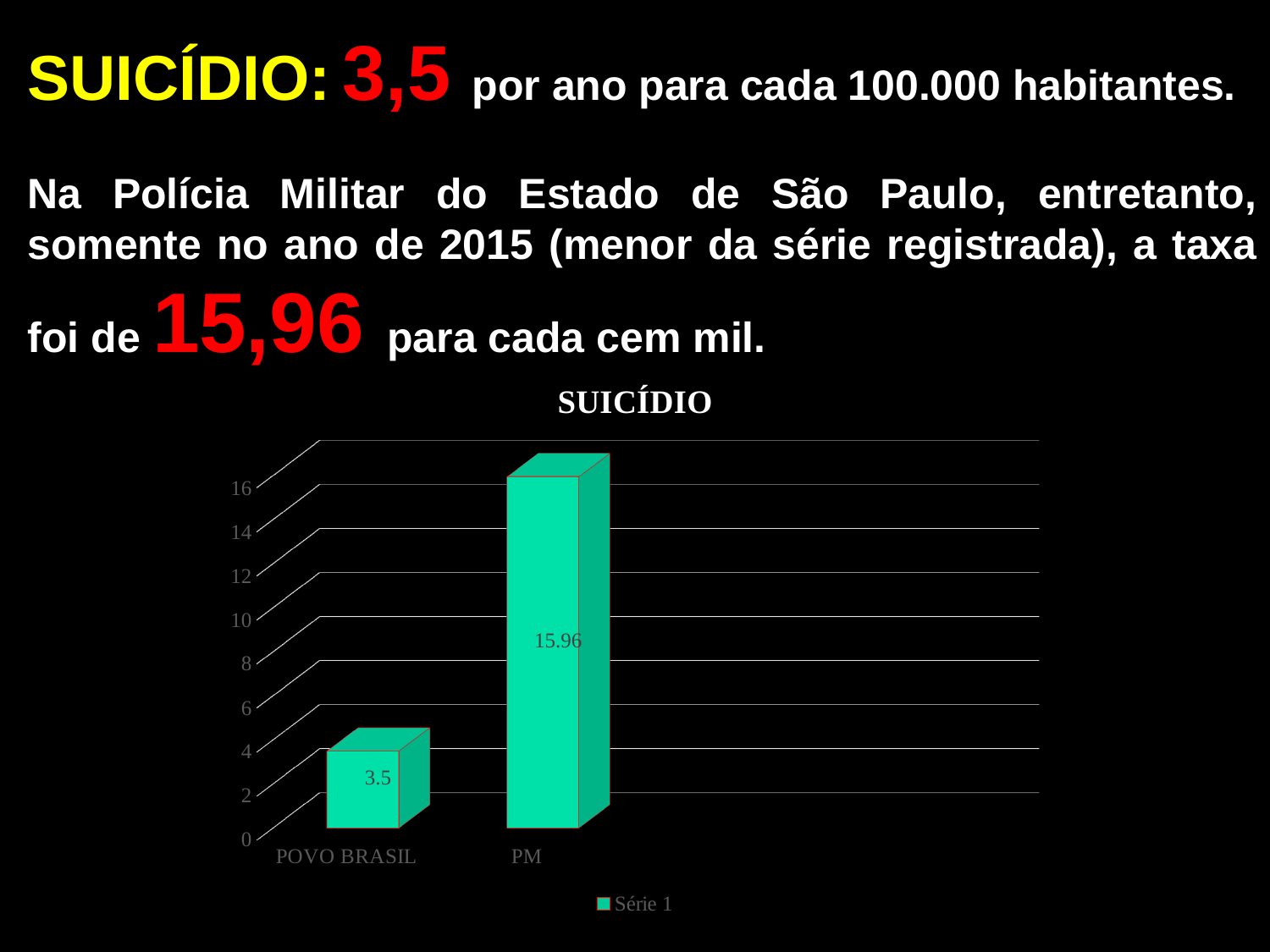
How many series does the legend of the SUICÍDIO chart list? 1 Which category has the highest value in the SUICÍDIO chart? PM Which category has the lowest value in the SUICÍDIO chart? POVO BRASIL What is the value for PM in the SUICÍDIO chart? 15.96 Is the value for POVO BRASIL in the SUICÍDIO chart greater or less than 6? less Is the value for PM in the SUICÍDIO chart greater or less than 10? greater What is the value for POVO BRASIL in the SUICÍDIO chart? 3.5 What is the name of the series shown in the legend of the SUICÍDIO chart? Série 1 What is the difference between the PM value and the POVO BRASIL value in the SUICÍDIO chart? 12.46 What kind of chart is the SUICÍDIO chart? Bar chart How many categories are shown in the SUICÍDIO chart? 2 Which is larger in the SUICÍDIO chart, the value for PM or the value for POVO BRASIL? PM